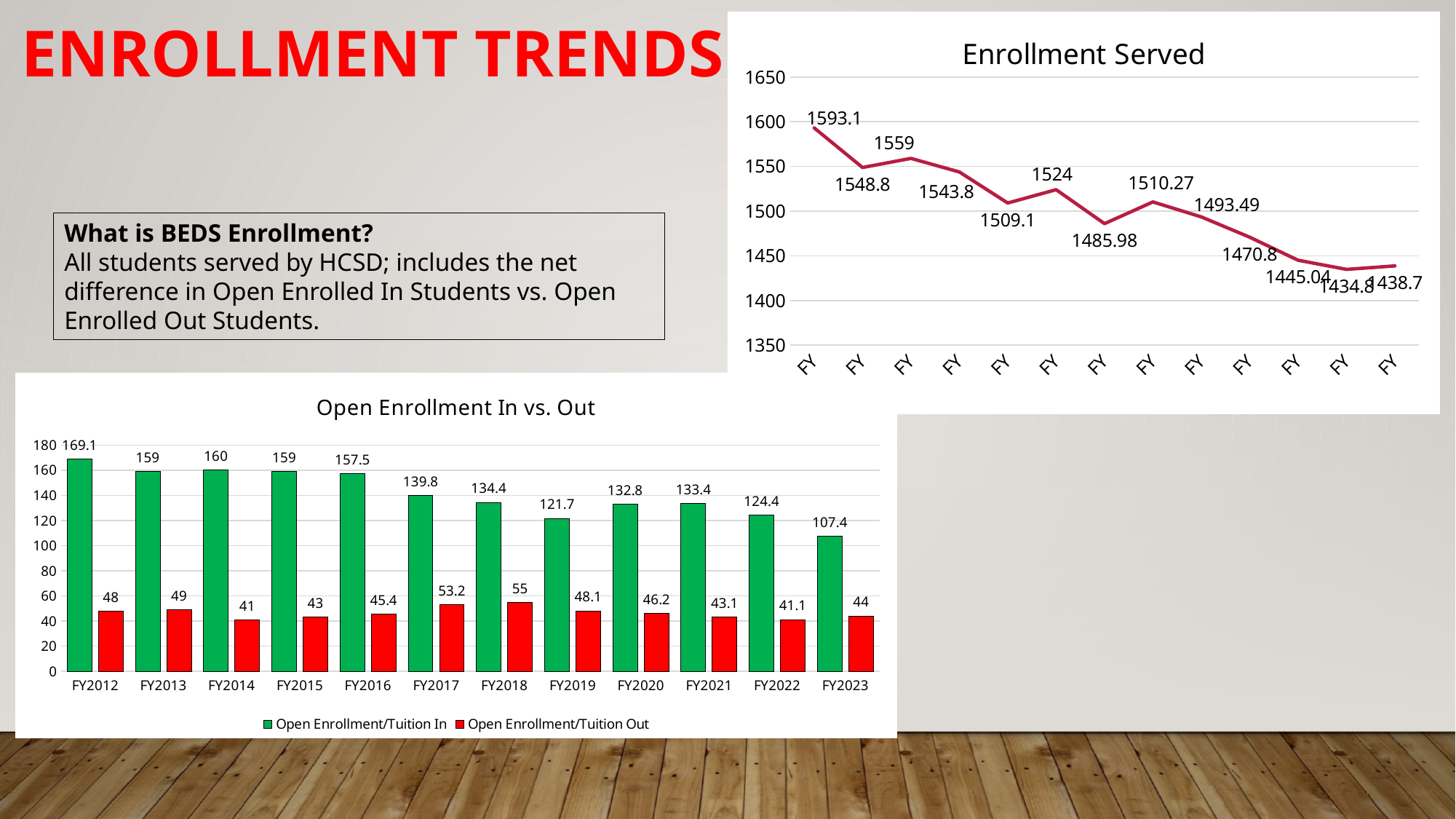
In the Open Enrollment In vs. Out chart, what is the Open Enrollment/Tuition In value for FY2018? 134.4 In the Open Enrollment In vs. Out chart, what is the difference between the Open Enrollment/Tuition In and Out values for FY2012? 121.1 What kind of chart is the Enrollment Served chart? line chart In the Open Enrollment In vs. Out chart, which fiscal year has the lowest Open Enrollment/Tuition In value? FY2023 In the Open Enrollment In vs. Out chart, what is the Open Enrollment/Tuition Out value for FY2017? 53.2 In the Enrollment Served chart, do the values generally rise or fall from left to right? fall How many fiscal years are shown on the x axis of the Open Enrollment In vs. Out chart? 12 How many series does the legend of the Open Enrollment In vs. Out chart list? 2 What kind of chart is the Open Enrollment In vs. Out chart? bar chart In the Open Enrollment In vs. Out chart, is the Open Enrollment/Tuition In value larger in FY2020 or FY2021? FY2021 In the Open Enrollment In vs. Out chart, which fiscal year has the highest Open Enrollment/Tuition Out value? FY2018 In the Enrollment Served chart, what is the highest value plotted? 1593.1